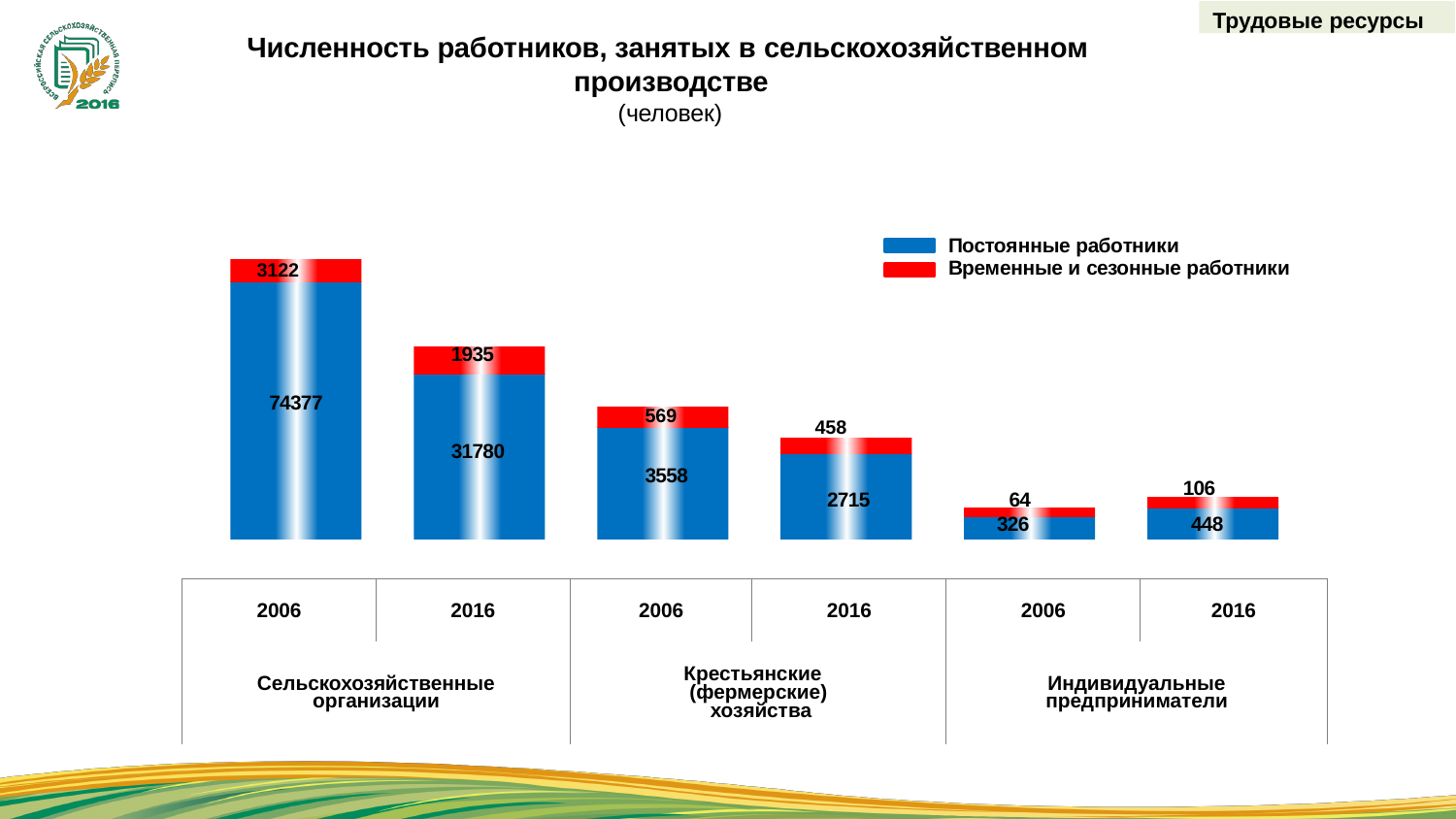
By how much did the number of permanent workers in agricultural organisations (Сельскохозяйственные организации) decrease from 2006 to 2016? 42597 What kind of chart is shown on the slide? Stacked bar chart What is the number of permanent workers in peasant (farm) holdings (Крестьянские (фермерские) хозяйства) in 2016? 2715 Which bar has the lowest number of permanent workers? Индивидуальные предприниматели, 2006 How many bars are plotted in the chart? 6 Which is larger: the number of permanent workers for individual entrepreneurs in 2006 or in 2016? 2016 Which bar has the highest number of permanent workers? Сельскохозяйственные организации, 2006 What is the number of permanent workers (Постоянные работники) in agricultural organisations (Сельскохозяйственные организации) in 2006? 74377 What is the number of temporary and seasonal workers for individual entrepreneurs (Индивидуальные предприниматели) in 2006? 64 What is the number of temporary and seasonal workers (Временные и сезонные работники) in agricultural organisations (Сельскохозяйственные организации) in 2016? 1935 How many series does the legend list? 2 What is the total number of workers (permanent plus temporary and seasonal) for individual entrepreneurs (Индивидуальные предприниматели) in 2016? 554